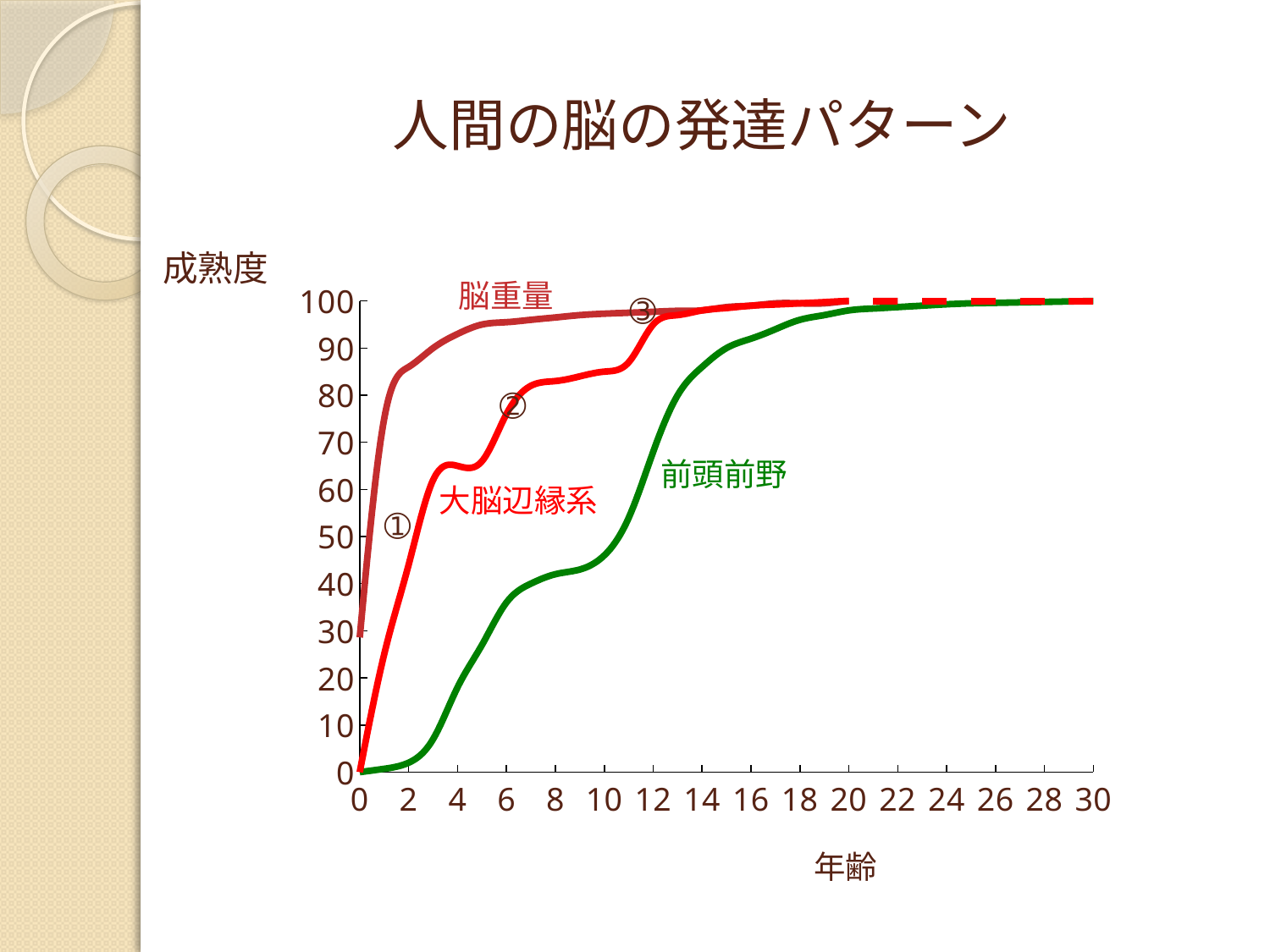
What kind of chart is shown on the slide? line chart How many curves (series) are plotted on the chart? 3 Do the values of the 前頭前野 curve rise or fall as age increases? rise At age 6, which curve is higher, 脳重量 or 前頭前野? 脳重量 What is the title of the chart? 人間の脳の発達パターン Which curve has the lowest value at age 8? 前頭前野 Is the value of 前頭前野 at age 20 greater or less than 90? greater What is the label of the x axis? 年齢 Is the value of 大脳辺縁系 at age 4 greater or less than 50? greater Is the value of 前頭前野 at age 10 greater or less than 50? less At age 10, which curve is higher, 大脳辺縁系 or 前頭前野? 大脳辺縁系